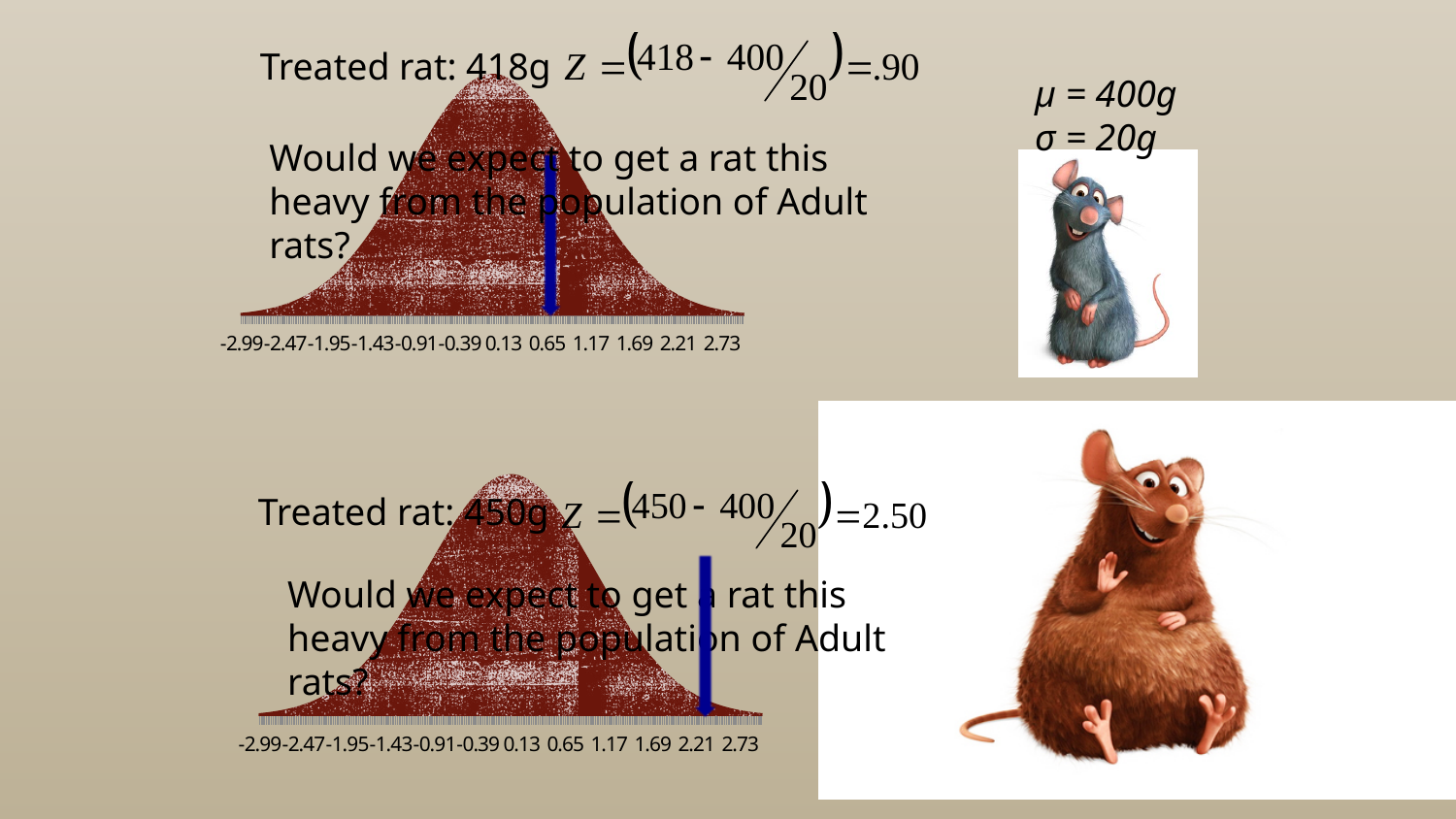
On the top chart, do the values rise or fall as the x axis moves from -2.99 toward the centre of the curve? rise On the bottom chart, do the values rise or fall as the x axis moves from 0.65 toward 2.73? fall How many tick labels are shown on the x axis of the top chart? 12 On the bottom chart, is the peak of the curve to the left or to the right of the blue arrow? left Which chart has its blue arrow further to the right along the x axis, the top chart or the bottom chart? bottom chart How many charts are shown on the slide? 2 What is the rightmost x-axis label on the top chart? 2.73 What kind of chart is the top chart on the slide? area chart What is the leftmost x-axis label on the bottom chart? -2.99